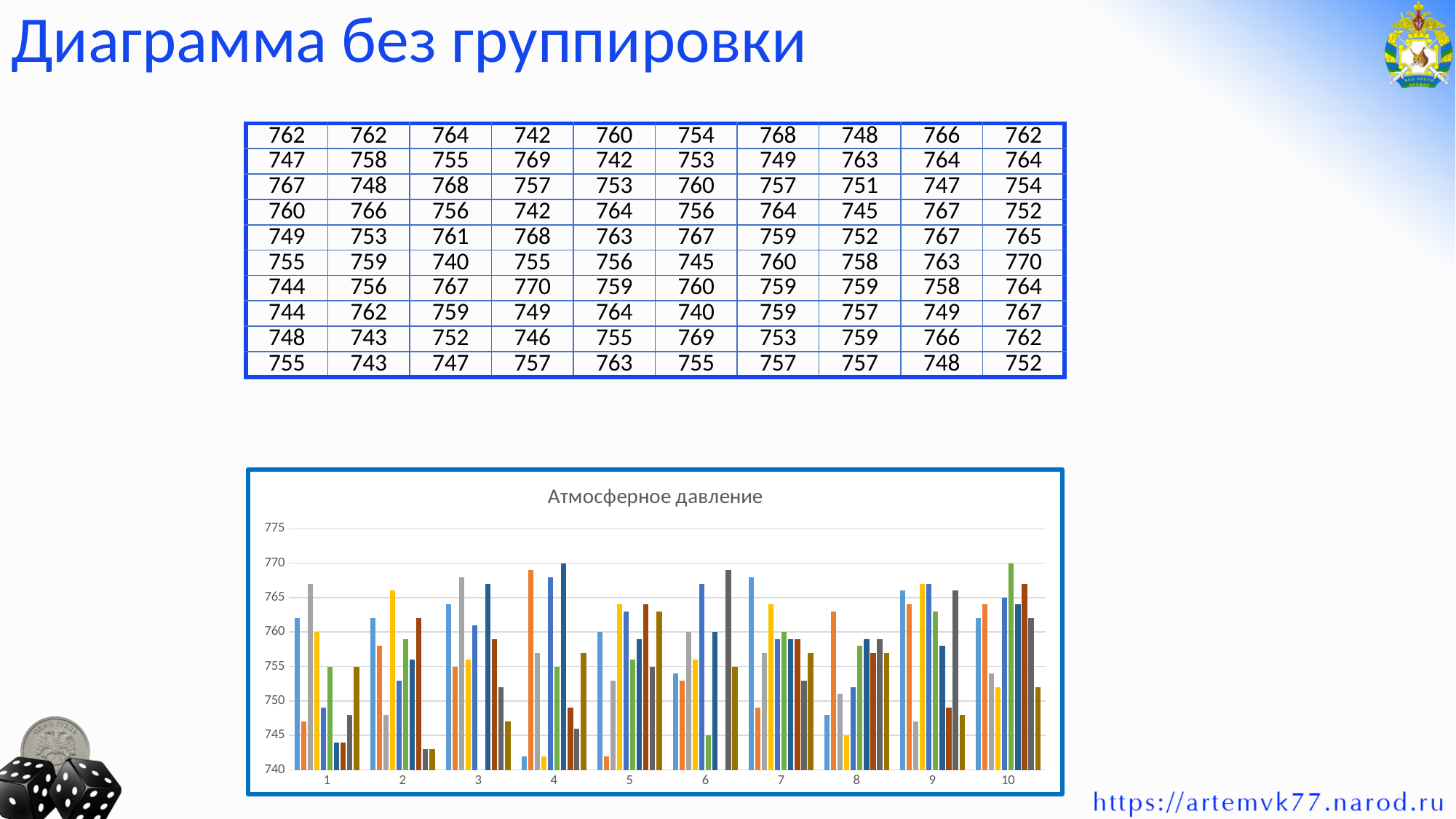
Is the value of the orange (second) bar in category 8 greater or less than 760? greater Is the value of the first (leftmost) bar in category 7 greater or less than 765? greater Is the value of the green bar in category 10 greater or less than 765? greater What is the title of the chart? Атмосферное давление What is the lowest value shown on the chart's vertical axis? 740 How many bars are plotted in each category of the chart? 10 How many categories are labelled along the x axis of the chart? 10 What kind of chart is shown on the slide? bar chart